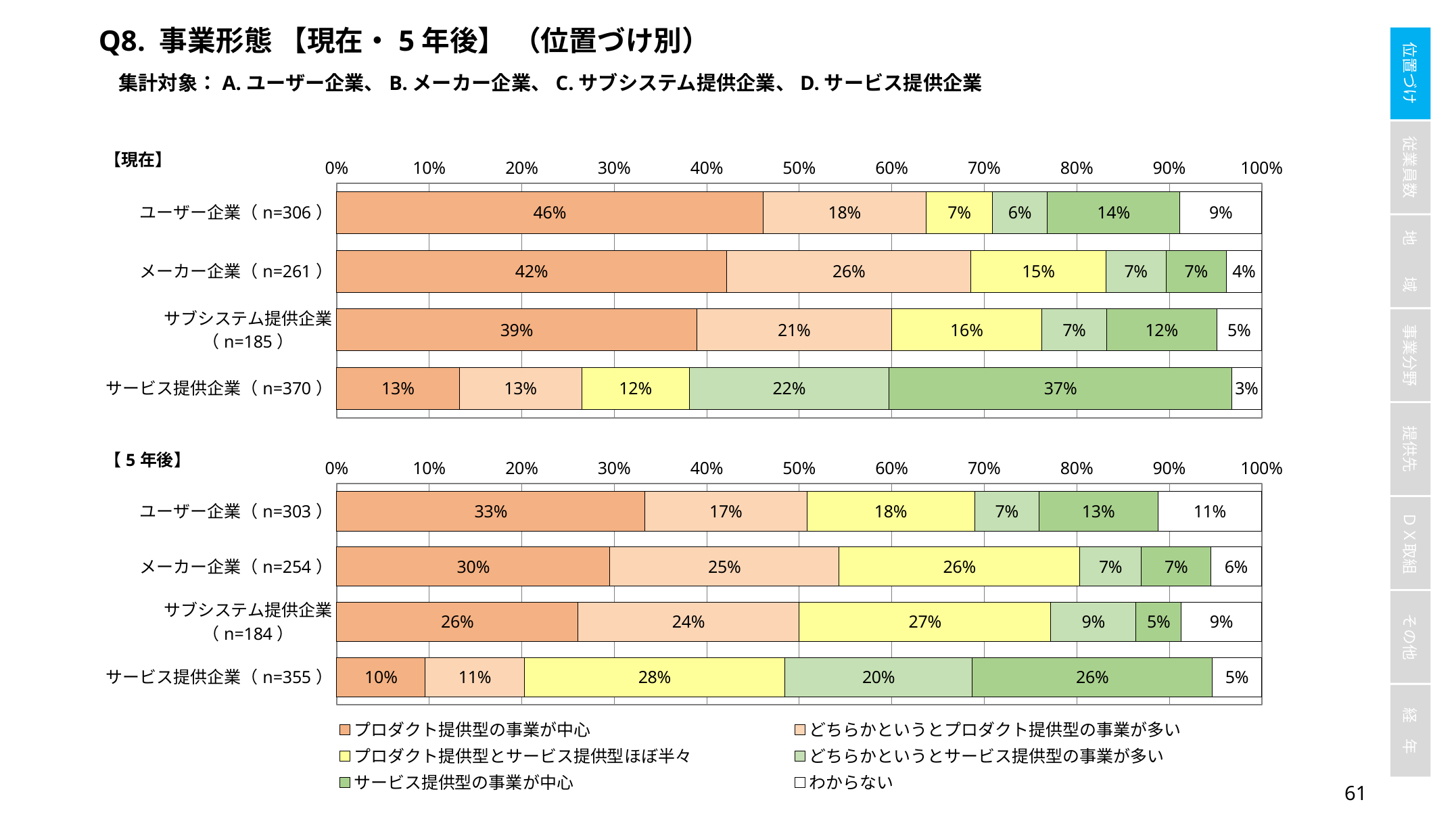
In the 【5年後】 chart, what is the value of プロダクト提供型とサービス提供型ほぼ半々 for サブシステム提供企業（n=184）? 27% In the 【現在】 chart, which is larger for サービス提供企業（n=370）: どちらかというとサービス提供型の事業が多い or サービス提供型の事業が中心? サービス提供型の事業が中心 In the 【5年後】 chart, what is the total of the プロダクト提供型の事業が中心 (10%) and どちらかというとプロダクト提供型の事業が多い (11%) segments for サービス提供企業（n=355）? 21% How many categories are shown in the 【5年後】 chart? 4 How many series does the legend list? 6 In the 【現在】 chart, which category has the highest value for プロダクト提供型の事業が中心? ユーザー企業（n=306） In the 【現在】 chart, what is the value of プロダクト提供型の事業が中心 for ユーザー企業（n=306）? 46% In the 【現在】 chart, what is the value of サービス提供型の事業が中心 for サービス提供企業（n=370）? 37% What is the difference between the プロダクト提供型の事業が中心 value for メーカー企業 in the 【現在】 chart (42%) and in the 【5年後】 chart (30%)? 12% In the 【5年後】 chart, what is the value of わからない for ユーザー企業（n=303）? 11% What kind of chart is the 【現在】 chart? Stacked bar chart In the 【5年後】 chart, which category has the lowest value for プロダクト提供型の事業が中心? サービス提供企業（n=355）